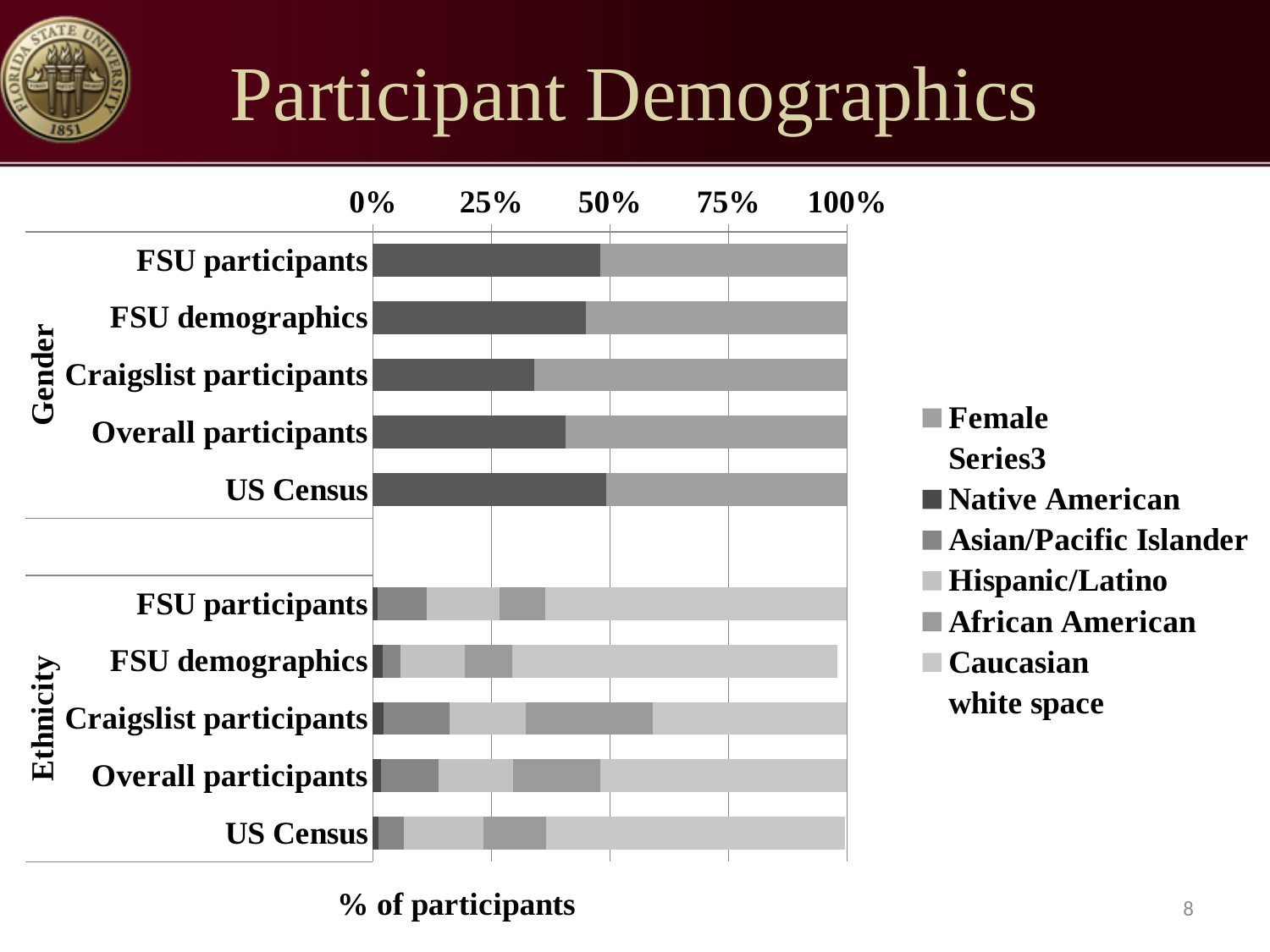
In the Gender group, is the dark (first) segment for Craigslist participants greater or less than 50%? less In the Ethnicity group, is the African American segment larger for Craigslist participants or for FSU participants? Craigslist participants In the Gender group, is the dark (first) segment larger for FSU participants or for Craigslist participants? FSU participants How many categories are plotted in the Gender group of the chart? 5 What is the first entry listed in the chart legend? Female How many entries does the chart legend list? 8 In the Gender group, is the dark (first) segment for Overall participants greater or less than 50%? less In the Ethnicity group, is the Caucasian segment for FSU demographics greater or less than 50%? greater How many bars are plotted in total across the Gender and Ethnicity groups? 10 What is the title of the horizontal axis? % of participants What kind of chart is shown on the slide? Stacked bar chart In the Gender group, which category has the smallest dark (first) segment? Craigslist participants